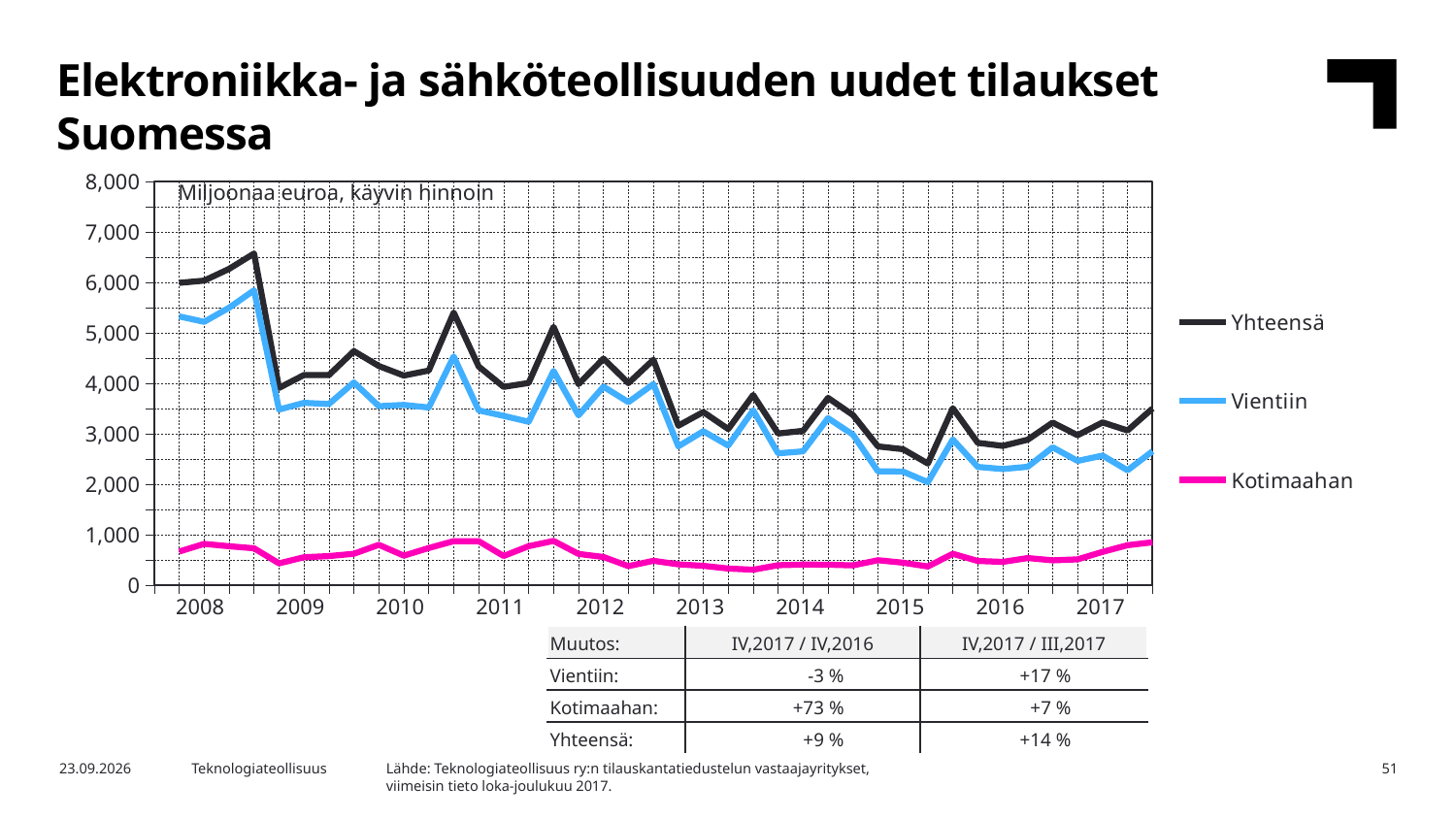
How many years are labelled on the x axis? 10 What are the three series named in the legend? Yhteensä, Vientiin, Kotimaahan What kind of chart is shown on the slide? line chart Is the peak value of Yhteensä in 2008 greater or less than 6,000? greater Which series is larger in 2016, Vientiin or Kotimaahan? Vientiin How many series does the legend list? 3 What unit is stated in the label inside the chart area? Miljoonaa euroa, käyvin hinnoin Which series has the highest values throughout the chart? Yhteensä Is the value for Kotimaahan in 2017 greater or less than 1,000? less Is the value for Vientiin at the start of 2008 greater or less than 5,000? greater Does the Yhteensä series overall rise or fall from 2008 to 2017? fall Which series has the lowest values throughout the chart? Kotimaahan